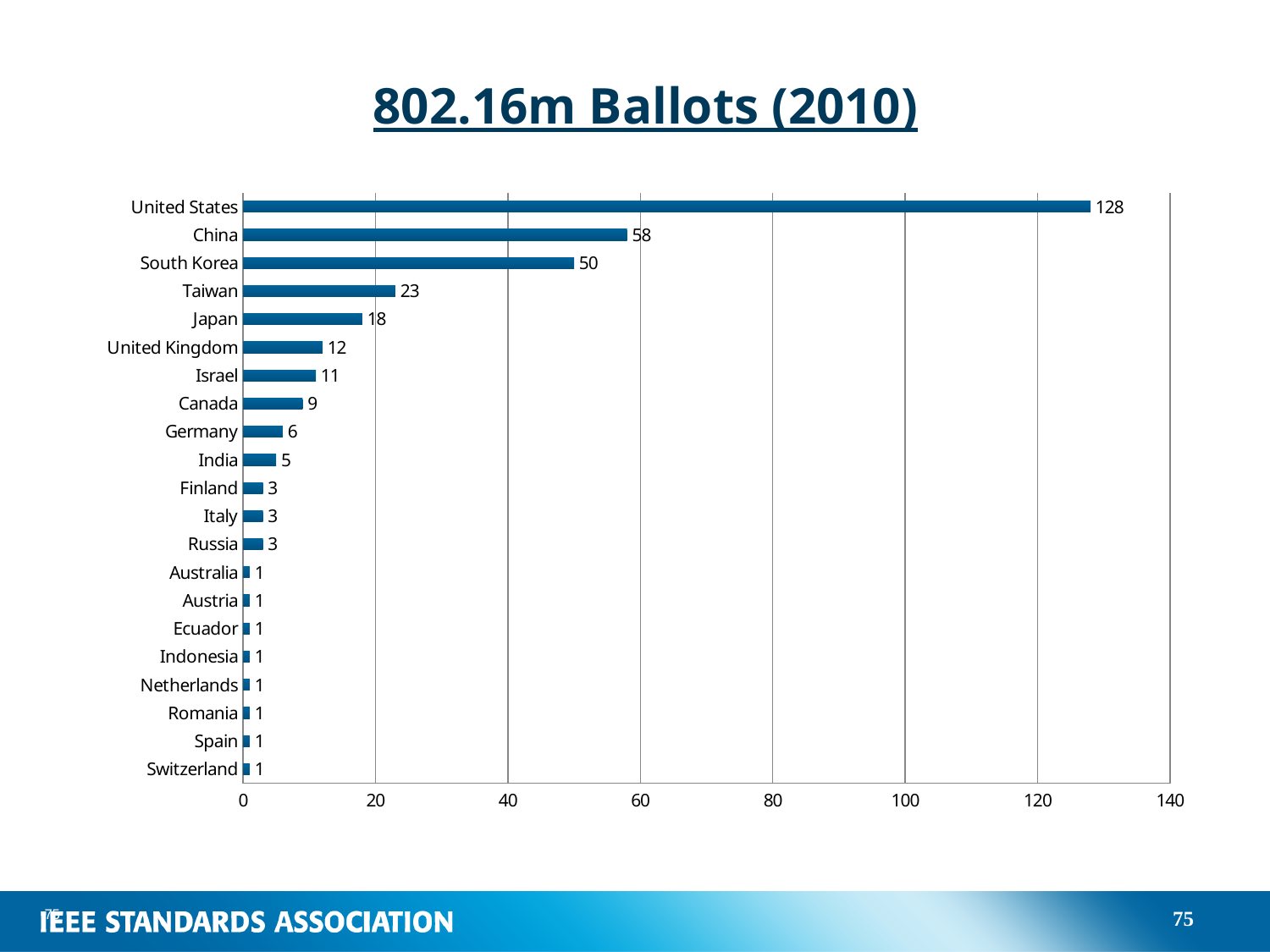
How many countries are shown in the chart? 21 Which is larger, the value for the United Kingdom or the value for Israel? United Kingdom Is the value for the United States greater or less than 120? greater What is the difference between the values for South Korea and Japan? 32 How many countries have a value of 1? 8 What is the value for Canada? 9 What is the title of the chart? 802.16m Ballots (2010) What is the value for Taiwan? 23 Which country has the highest value? United States What is the value for China? 58 What is the difference between the values for the United States and China? 70 What kind of chart is shown on the slide? bar chart